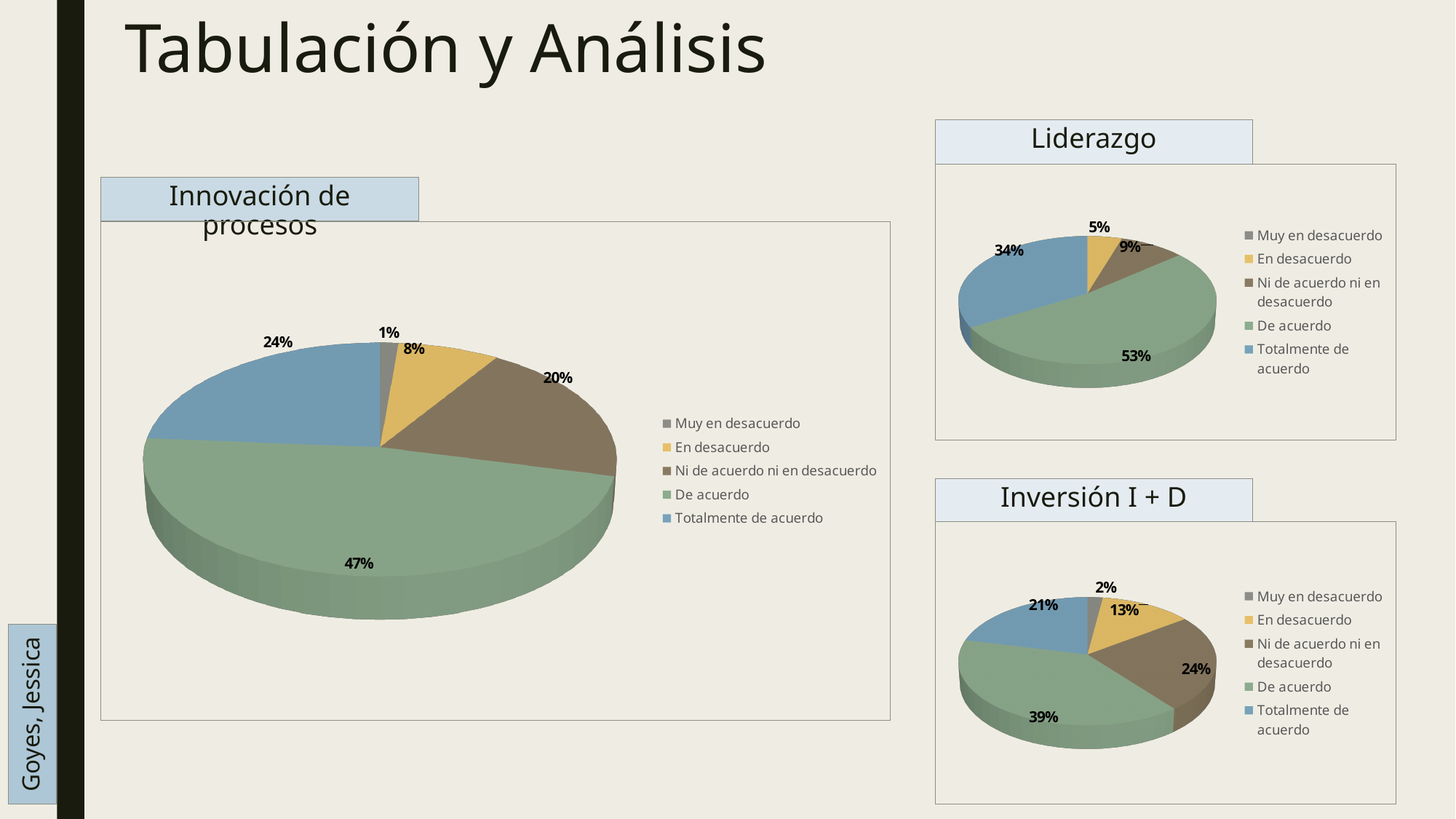
In the 'Liderazgo' chart, what share is labelled for 'De acuerdo'? 53% In the 'Innovación de procesos' chart, what share is labelled for 'De acuerdo'? 47% How many entries does the legend of the 'Liderazgo' chart list? 5 In the 'Innovación de procesos' chart, which category has the smallest slice? Muy en desacuerdo In the 'Inversión I + D' chart, what is the difference between the 'De acuerdo' slice and the 'Totalmente de acuerdo' slice? 18% In the 'Inversión I + D' chart, which is larger, the 'En desacuerdo' slice or the 'Totalmente de acuerdo' slice? Totalmente de acuerdo What type of chart is used for 'Inversión I + D'? Pie chart In the 'Inversión I + D' chart, what share is labelled for 'Ni de acuerdo ni en desacuerdo'? 24% In the 'Liderazgo' chart, what share is labelled for 'Totalmente de acuerdo'? 34% In the 'Liderazgo' chart, which category has the largest slice? De acuerdo In the 'Innovación de procesos' chart, what is the difference between the 'Ni de acuerdo ni en desacuerdo' slice and the 'En desacuerdo' slice? 12% In the 'Innovación de procesos' chart, what share is labelled for 'Totalmente de acuerdo'? 24%